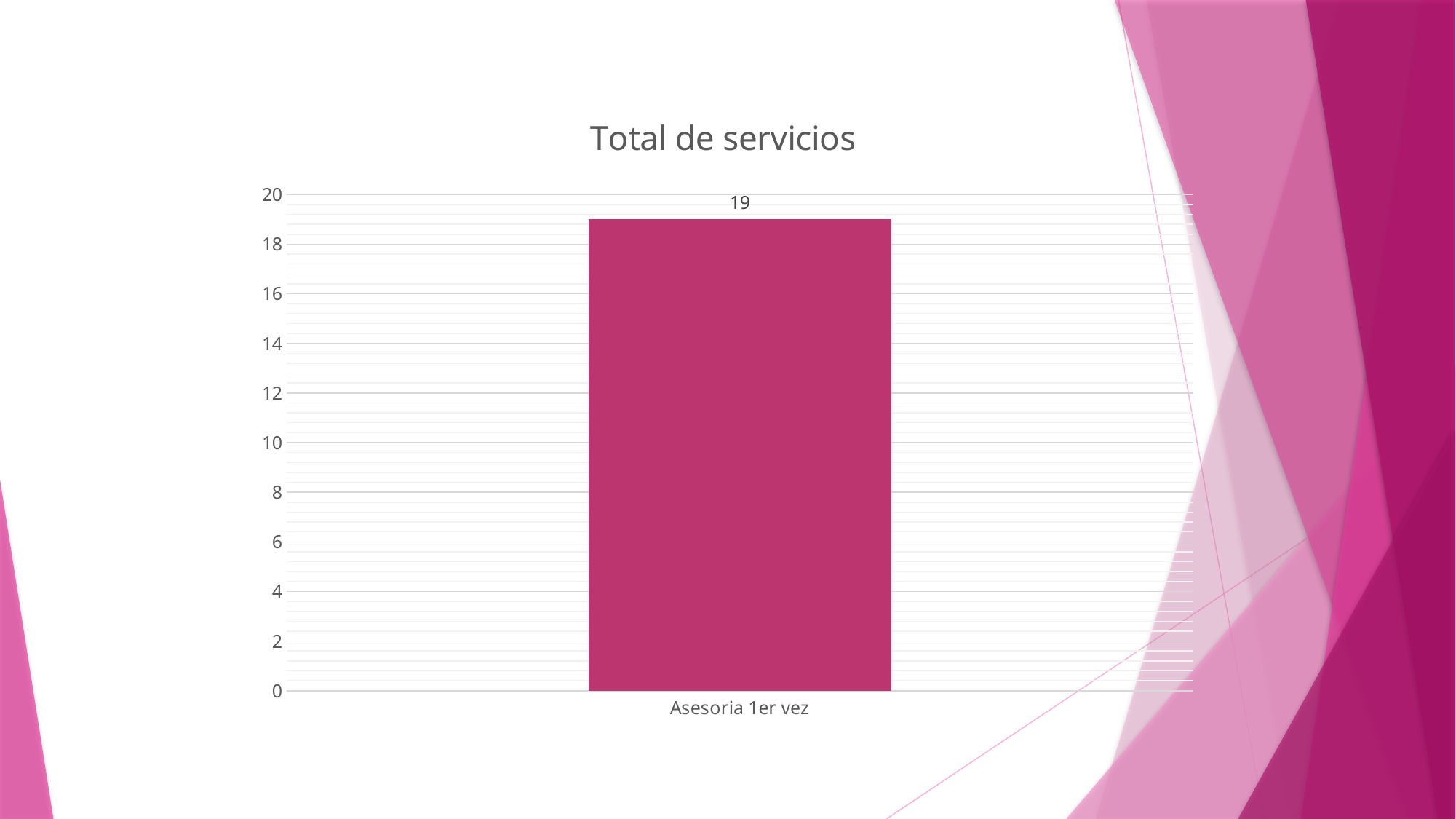
Is the value for Asesoria 1er vez greater or less than 20? less What is the value for Asesoria 1er vez? 19 What kind of chart is shown on the slide? bar chart How many categories are plotted in the chart? 1 What is the label of the only category on the x axis? Asesoria 1er vez What is the maximum value shown on the vertical axis? 20 What is the title of the chart? Total de servicios Is the value for Asesoria 1er vez greater or less than 10? greater